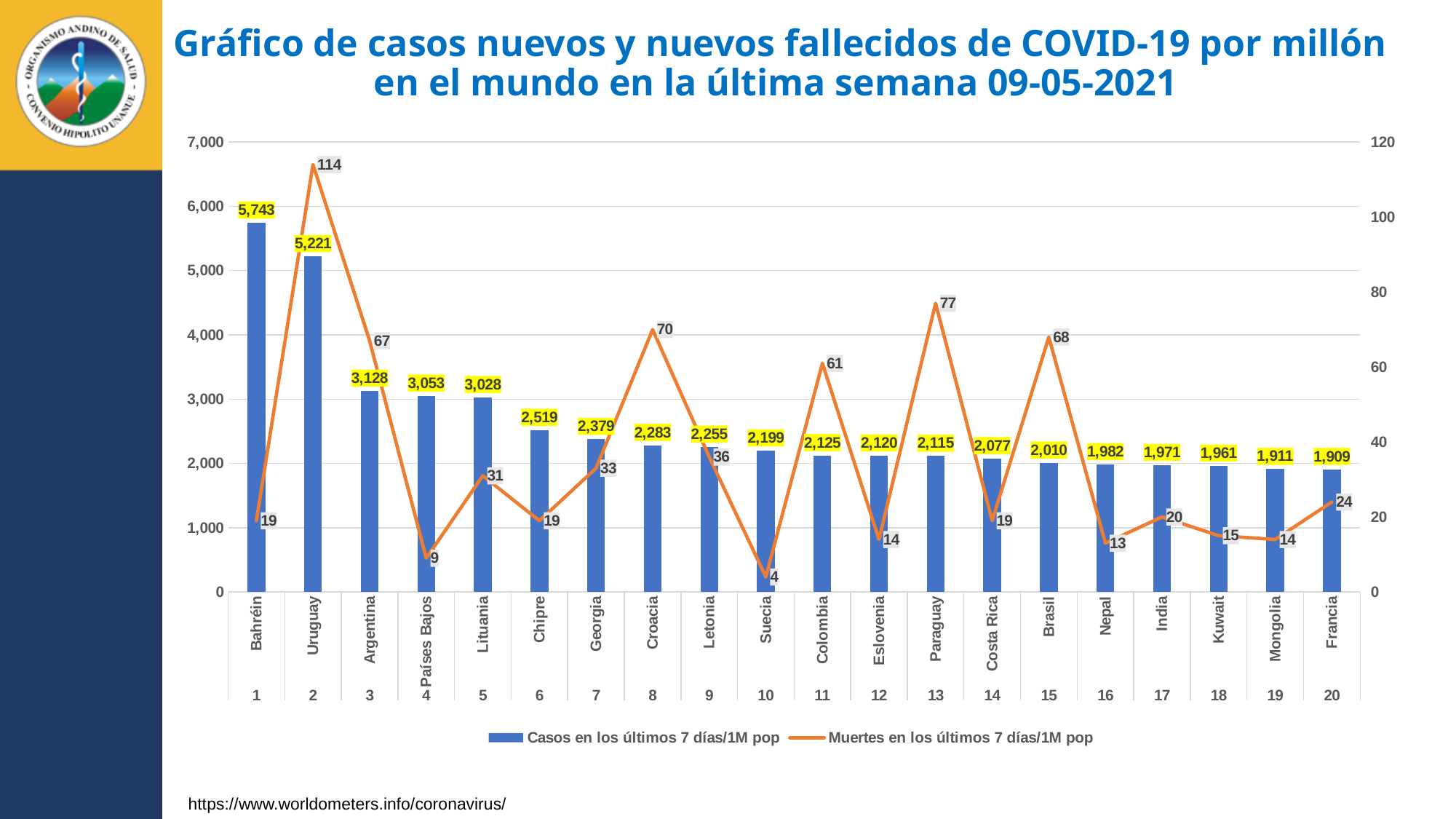
How many series does the legend list? 2 Do the values of 'Casos en los últimos 7 días/1M pop' rise or fall from left to right along the x axis? Fall What is the difference in 'Casos en los últimos 7 días/1M pop' between Bahréin and Uruguay? 522 What is the value of 'Casos en los últimos 7 días/1M pop' for Paraguay? 2,115 Which has a higher value of 'Muertes en los últimos 7 días/1M pop', Croacia or Brasil? Croacia What is the value of 'Muertes en los últimos 7 días/1M pop' for Suecia? 4 Which country has the lowest value of 'Muertes en los últimos 7 días/1M pop'? Suecia What kind of chart is this? Combined bar and line chart How many countries are shown on the chart? 20 What is the value of 'Casos en los últimos 7 días/1M pop' for Bahréin? 5,743 What is the value of 'Muertes en los últimos 7 días/1M pop' for Uruguay? 114 Which country has the highest value of 'Casos en los últimos 7 días/1M pop'? Bahréin